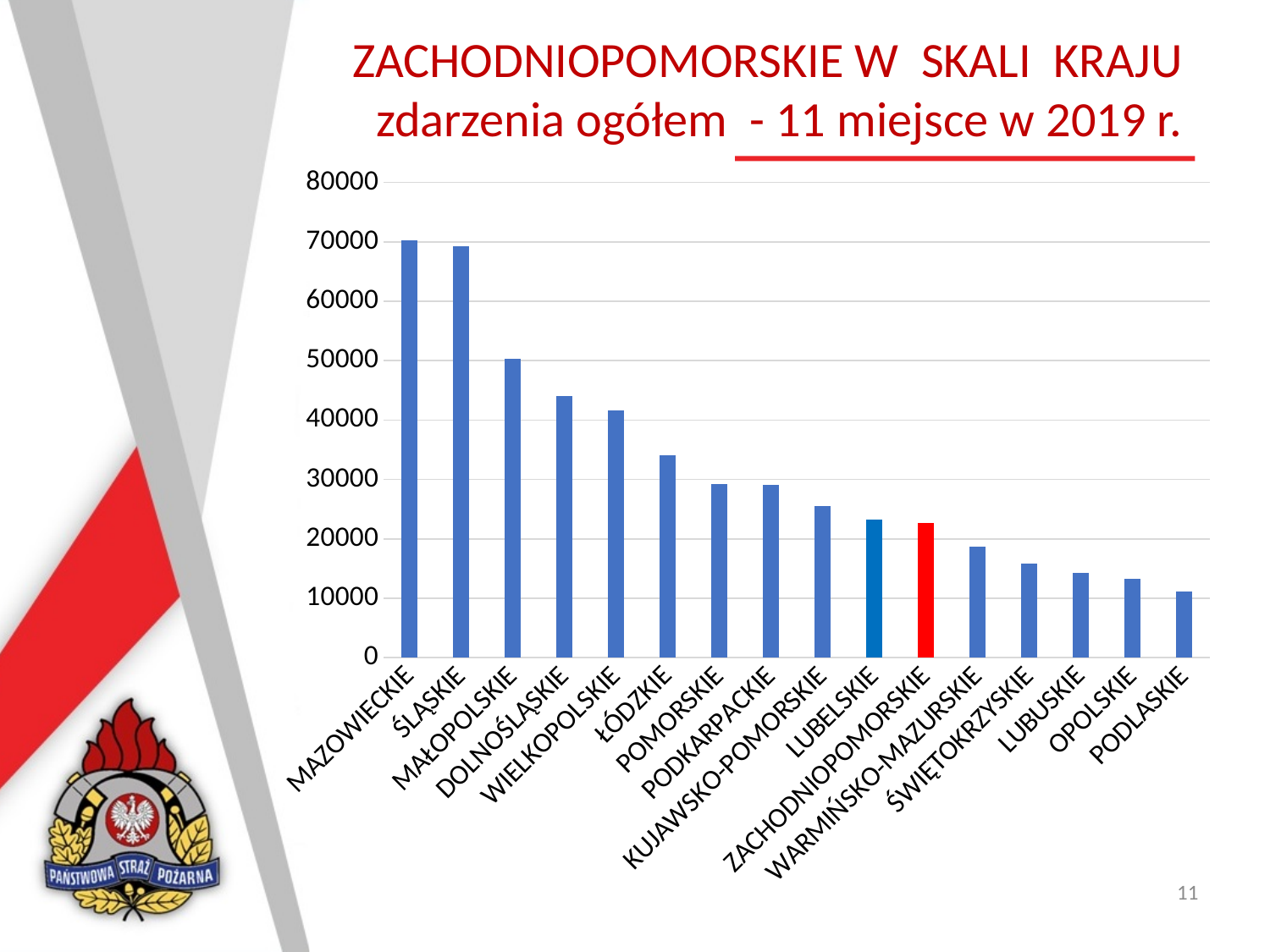
Is the value for WARMIŃSKO-MAZURSKIE greater or less than 20000? less Is the value for ZACHODNIOPOMORSKIE greater or less than 20000? greater What kind of chart is shown on the slide? bar chart Is the value for ŁÓDZKIE greater or less than 30000? greater Which category has the lowest value? PODLASKIE Which has the larger value, ŁÓDZKIE or POMORSKIE? ŁÓDZKIE How many voivodeships (categories) are shown on the x axis? 16 Which has the larger value, DOLNOŚLĄSKIE or WIELKOPOLSKIE? DOLNOŚLĄSKIE Which category's bar is coloured red? ZACHODNIOPOMORSKIE Do the values rise or fall from left to right along the x axis? fall